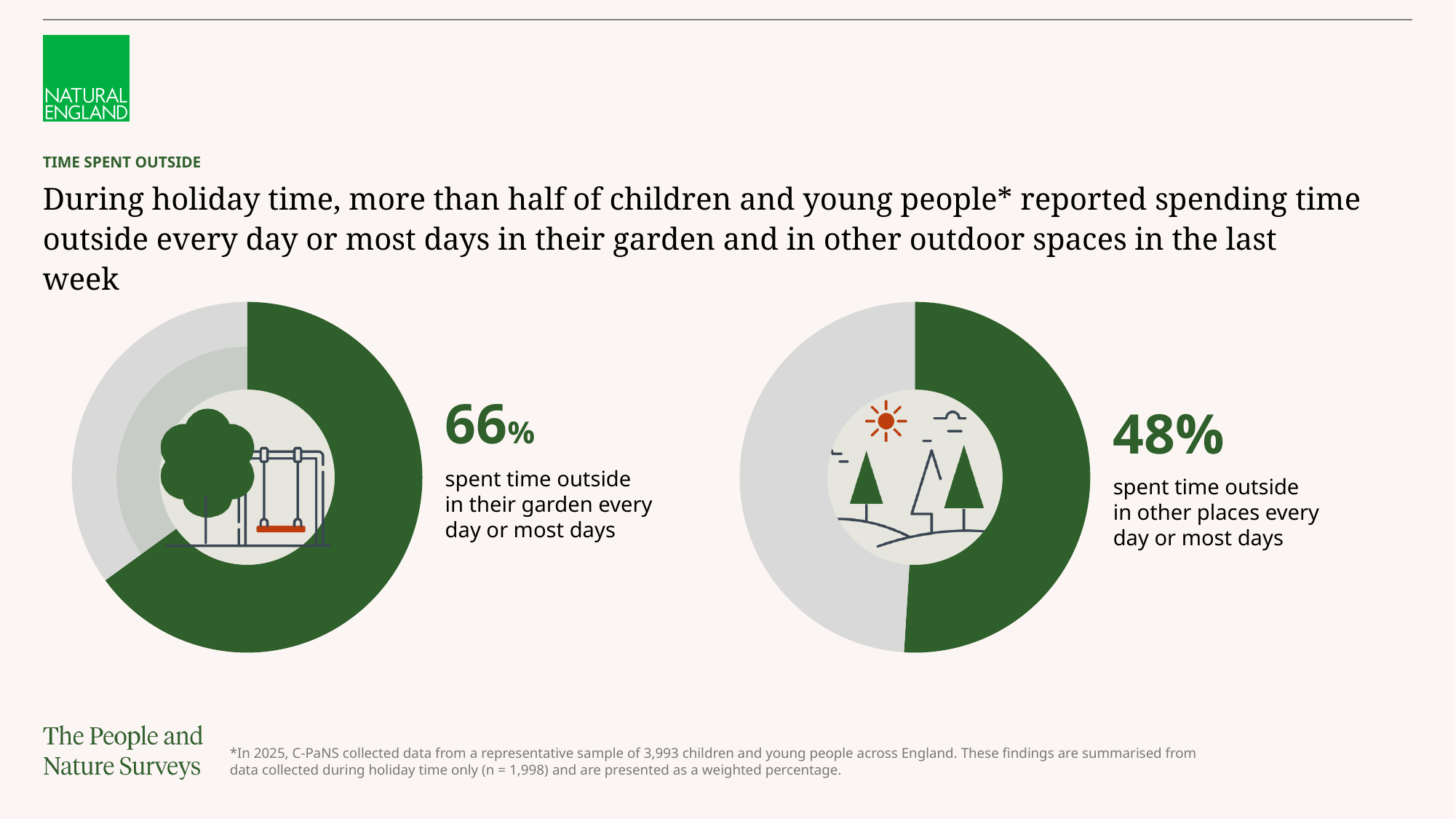
Which is larger: the percentage who spent time outside in their garden every day or most days (left chart) or the percentage who spent time outside in other places every day or most days (right chart)? In their garden (66%) How many donut charts are shown on the slide? 2 What is the difference in percentage points between the left chart's value (garden) and the right chart's value (other places)? 18 percentage points What kind of chart is used on the left of the slide to show the 66% figure? Donut (pie) chart What is the section heading shown above the slide title, in green capital letters? TIME SPENT OUTSIDE On the left donut chart, is the value for spending time outside in the garden every day or most days greater or less than 50%? greater What colour is used for the highlighted segment in both donut charts? Dark green On the right donut chart, is the value for spending time outside in other places every day or most days greater or less than 50%? less On the left donut chart, what percentage of children and young people spent time outside in their garden every day or most days? 66% On the right donut chart, what percentage of children and young people spent time outside in other places every day or most days? 48%